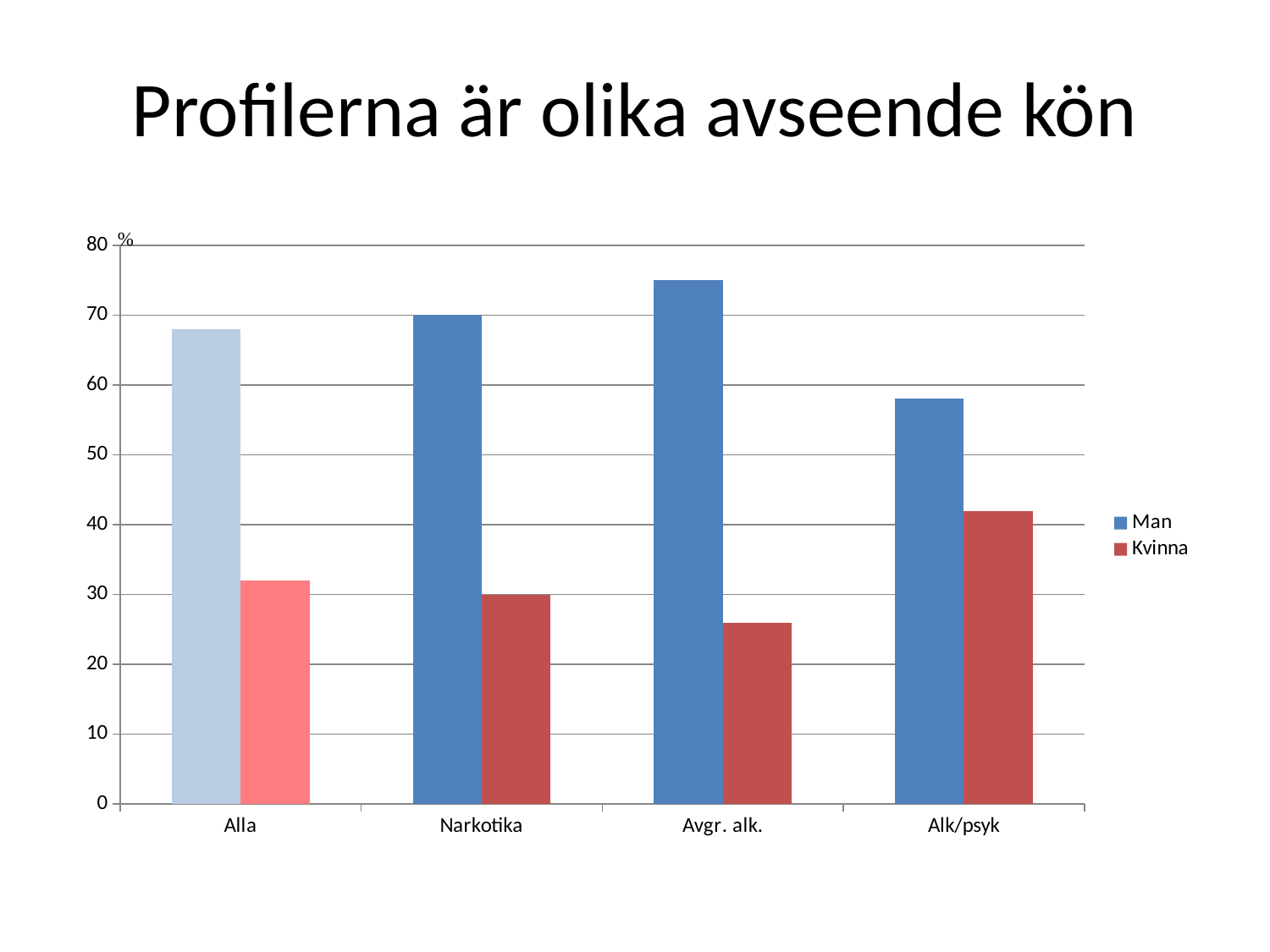
What are the two series named in the legend? Man and Kvinna What kind of chart is shown on the slide? bar chart Is the value for Man in the Avgr. alk. category greater or less than 70? greater Which category has the highest value for Man? Avgr. alk. Is the value for Kvinna in the Avgr. alk. category greater or less than 30? less Which category has the highest value for Kvinna? Alk/psyk What is the title of the slide? Profilerna är olika avseende kön How many categories are shown on the x axis? 4 How many series does the legend list? 2 Which category has the lowest value for Kvinna? Avgr. alk. Which category has the lowest value for Man? Alk/psyk What is the value for Man in the Narkotika category? 70